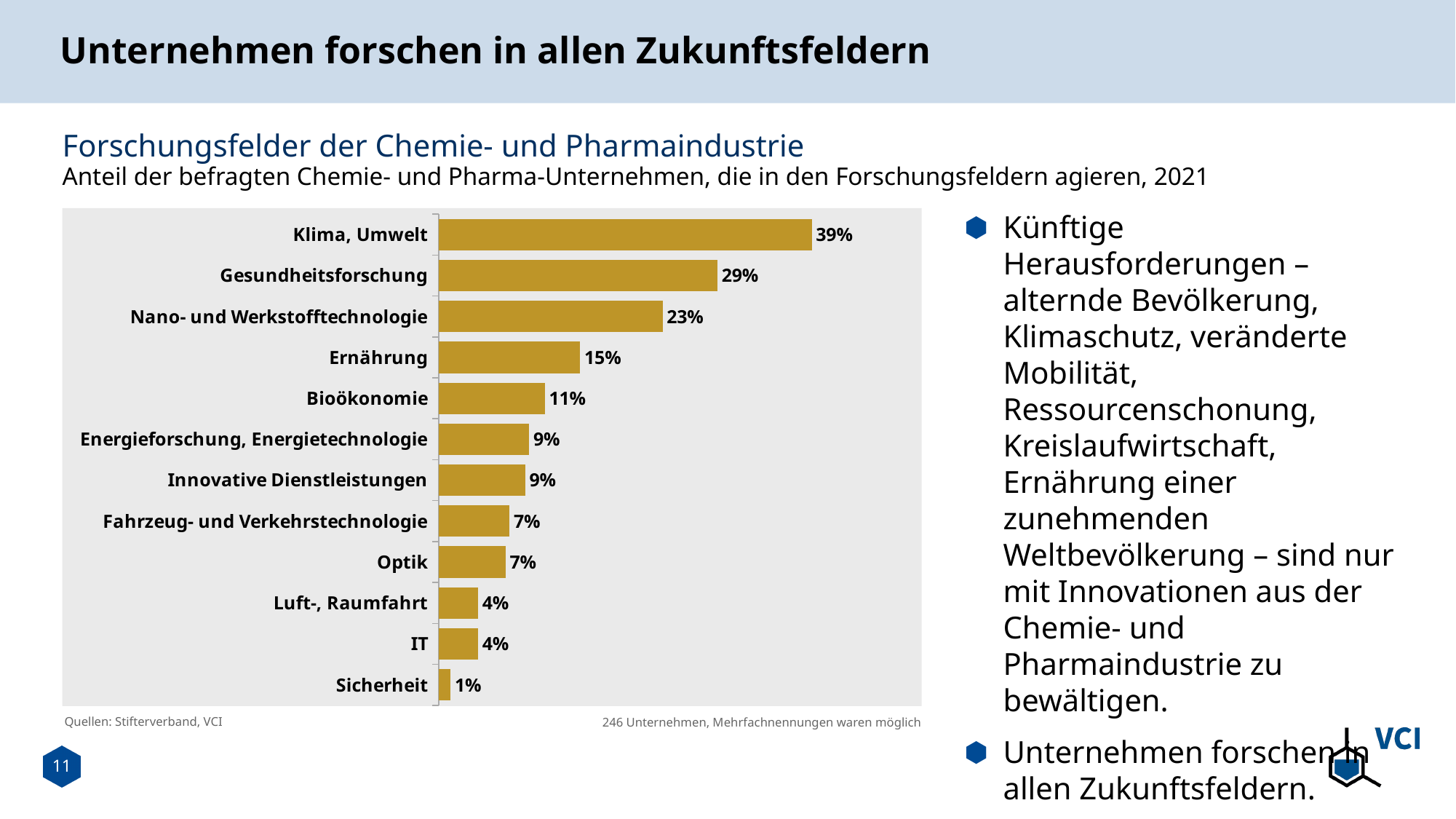
What is the difference between Klima, Umwelt and Gesundheitsforschung? 10% What is the difference between Ernährung and Bioökonomie? 4% What is the title of the chart? Forschungsfelder der Chemie- und Pharmaindustrie What kind of chart is shown on the slide? Bar chart What is the value for Bioökonomie? 11% Which research field has the highest share? Klima, Umwelt Which is larger, Gesundheitsforschung or Nano- und Werkstofftechnologie? Gesundheitsforschung How many research fields are shown in the chart? 12 Which research field has the lowest share? Sicherheit What is the value for Nano- und Werkstofftechnologie? 23% What is the value for Klima, Umwelt? 39% What is the value for Sicherheit? 1%